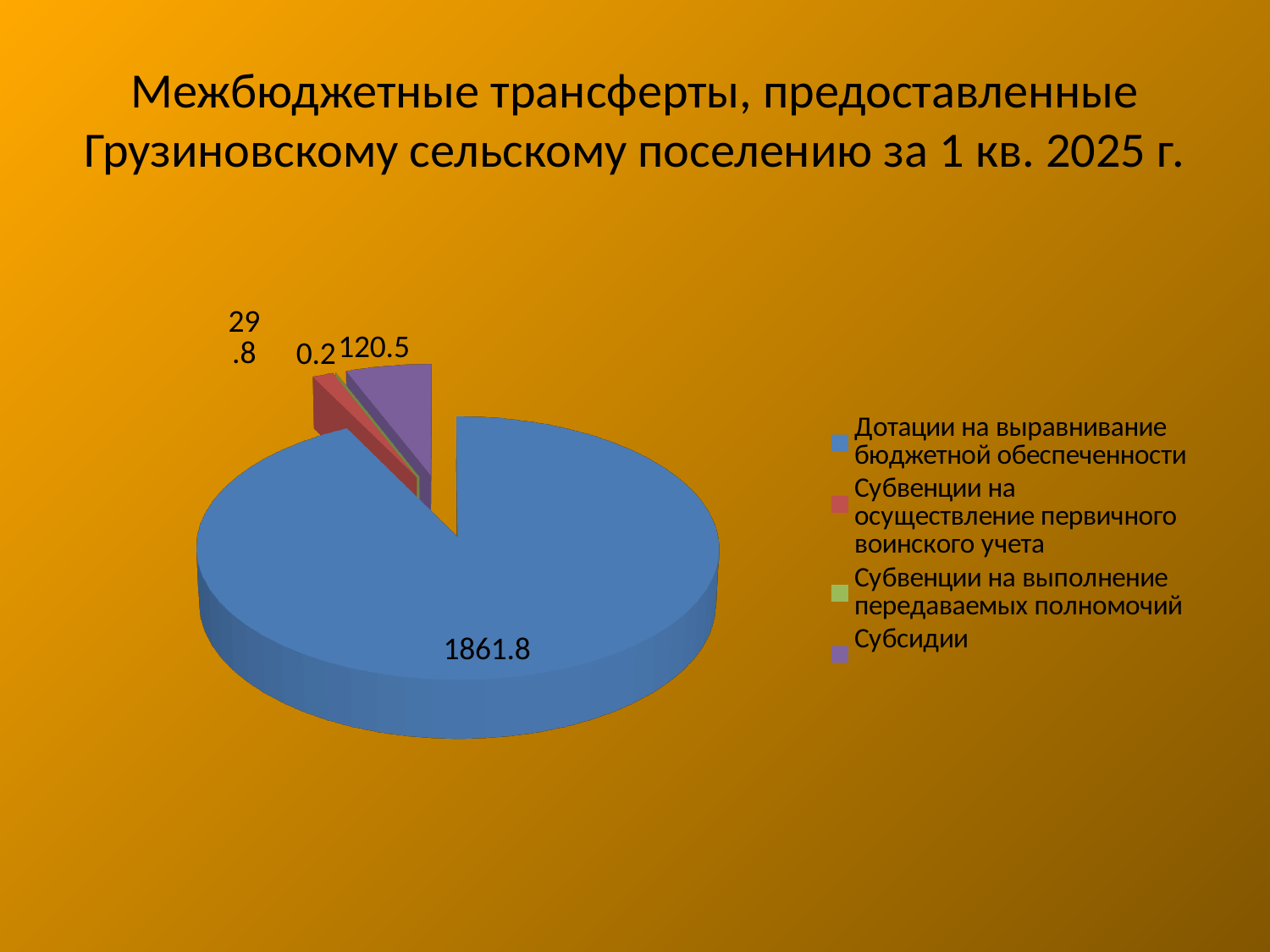
Which is larger: the value for Субсидии or the value for Субвенции на осуществление первичного воинского учета? Субсидии What is the value for Дотации на выравнивание бюджетной обеспеченности? 1861.8 What kind of chart is shown on the slide? pie chart What is the value for Субвенции на осуществление первичного воинского учета? 29.8 What is the value for Субвенции на выполнение передаваемых полномочий? 0.2 How many slices does the pie chart have? 4 How many entries does the legend list? 4 Which category has the largest slice of the pie? Дотации на выравнивание бюджетной обеспеченности Which category has the smallest slice of the pie? Субвенции на выполнение передаваемых полномочий What colour is the slice for Субсидии? purple What is the value for Субсидии? 120.5 What is the difference between the value for Субсидии and the value for Субвенции на осуществление первичного воинского учета? 90.7